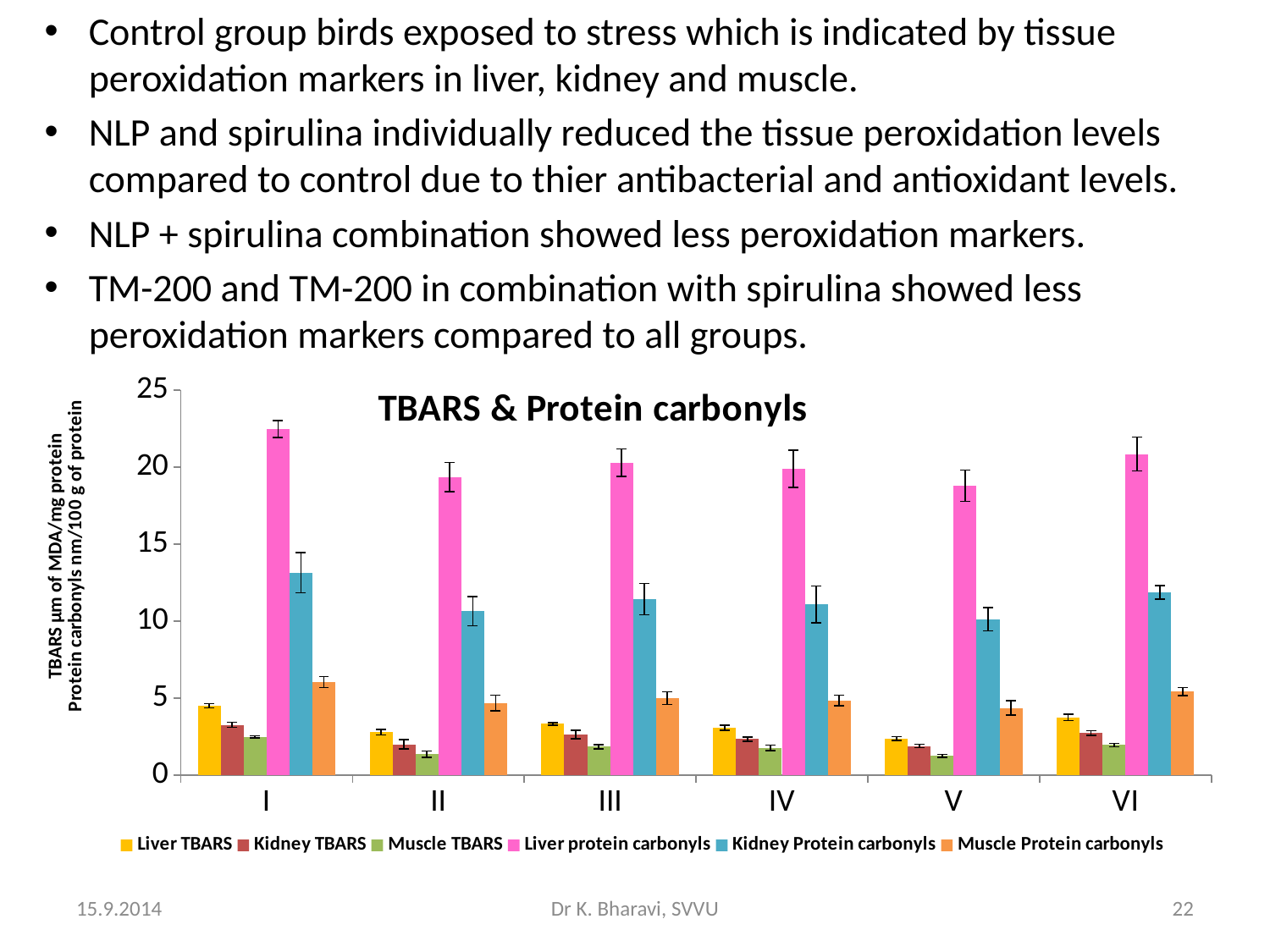
How many groups (categories) are shown along the x axis of the chart? 6 Which is larger, the Liver TBARS value for group I or for group VI? Group I Is the Muscle Protein carbonyls value for group I greater or less than 5? greater Which group has the highest Liver protein carbonyls value? I What kind of chart is shown on the slide? Bar chart Is the Liver protein carbonyls value for group I greater or less than 20? greater Which is larger, the Kidney Protein carbonyls value for group I or for group II? Group I How many series does the chart legend list? 6 What is the title of the chart? TBARS & Protein carbonyls Which group has the lowest Liver TBARS value? V Which series has the tallest bar in group I? Liver protein carbonyls Is the Kidney Protein carbonyls value for group V greater or less than 15? less